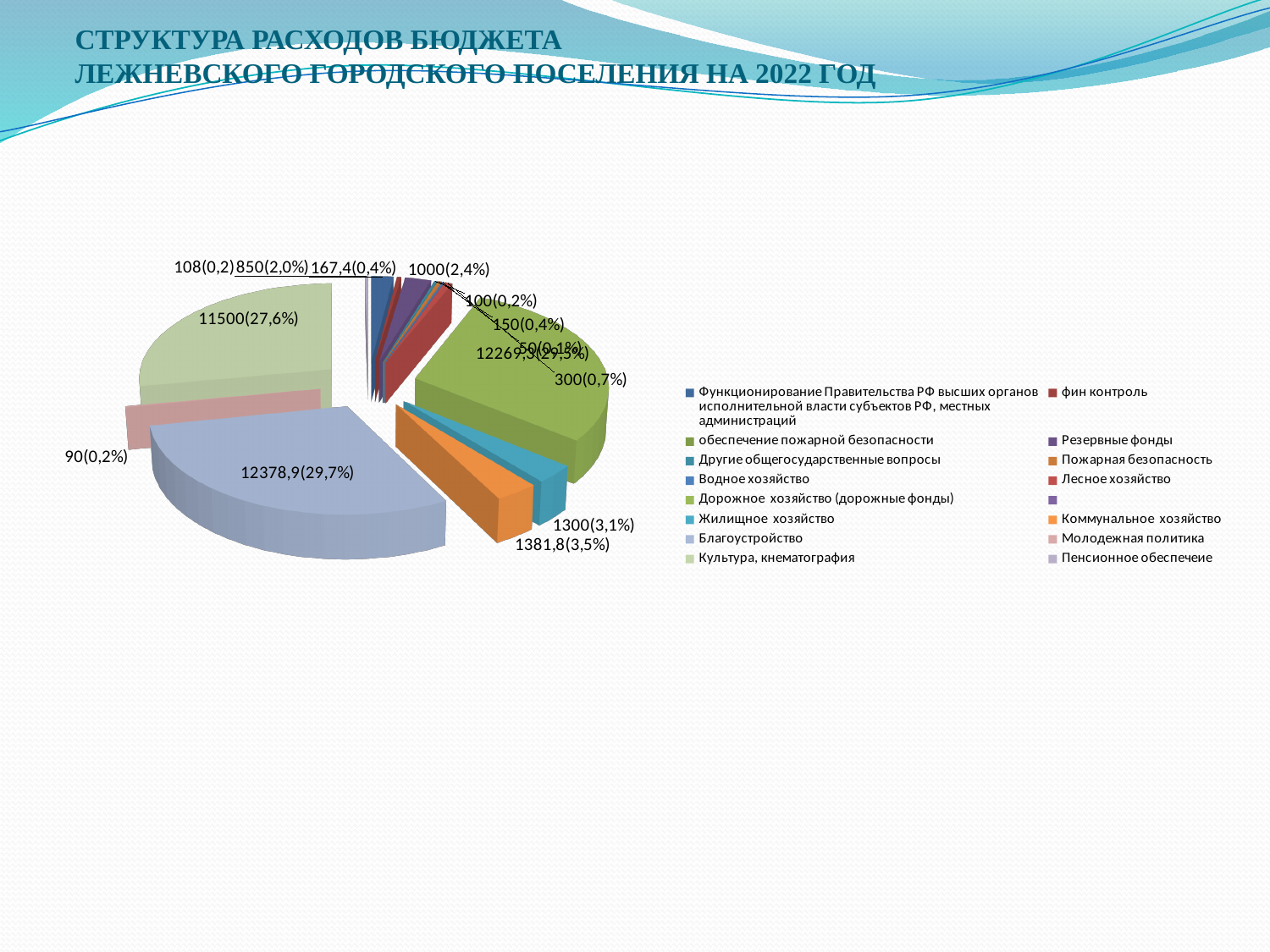
What value is shown for Благоустройство? 12378,9(29,7%) What kind of chart is shown on the slide? pie chart Which category has the largest slice of the pie? Благоустройство Which is larger, Дорожное хозяйство (дорожные фонды) or Культура, кнематография? Дорожное хозяйство (дорожные фонды) What is the difference between the values for Коммунальное хозяйство and Жилищное хозяйство? 81,8 What share of the pie does Благоустройство take? 29,7% What value is shown for Жилищное хозяйство? 1300(3,1%) What value is shown for Дорожное хозяйство (дорожные фонды)? 12269,3(29,5%) How many named categories does the legend list? 15 What value is shown for Культура, кнематография? 11500(27,6%) For which year does the slide title say the budget expenditure structure is shown? 2022 What value is shown for Коммунальное хозяйство? 1381,8(3,5%)